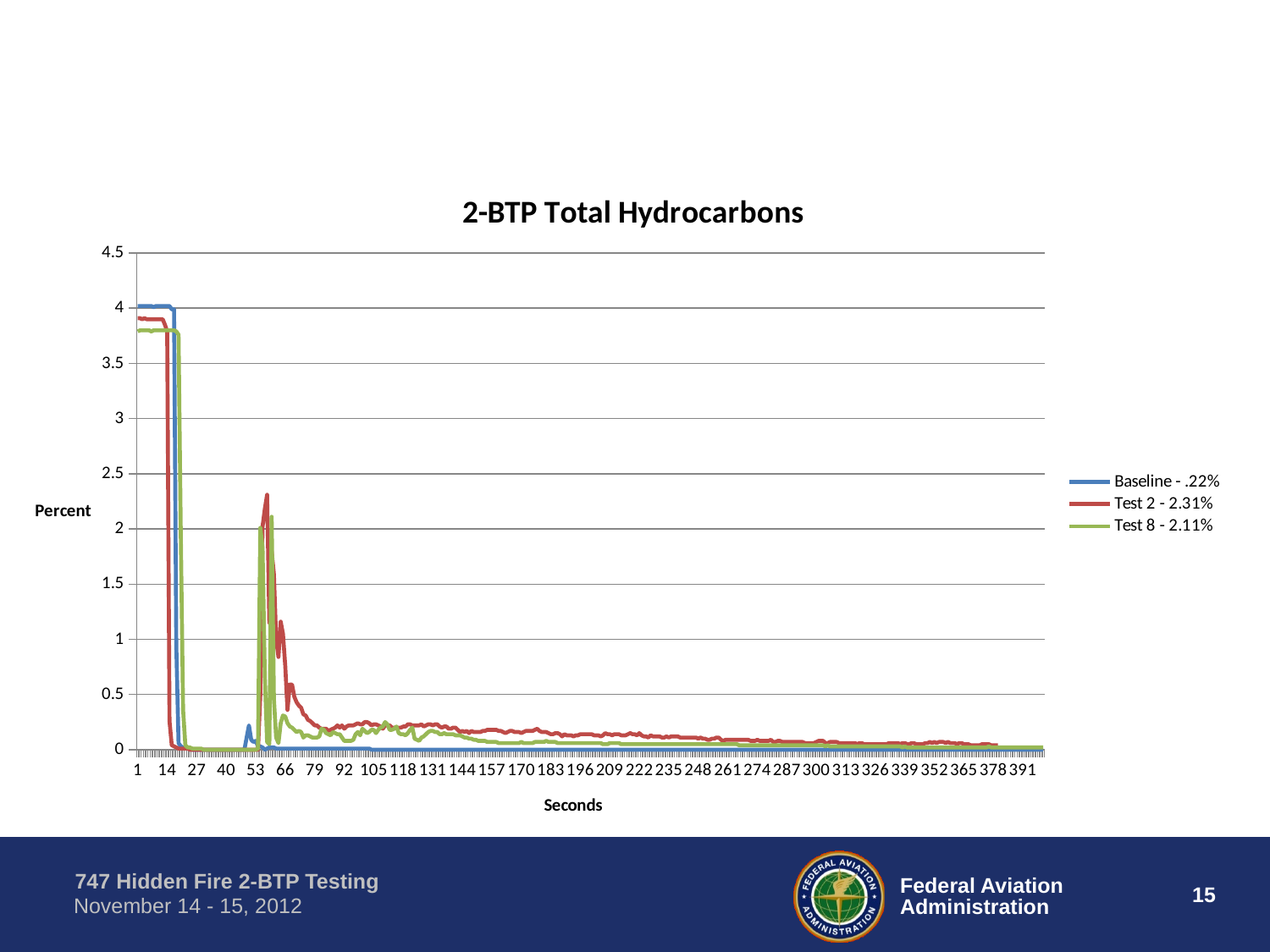
At around 200 seconds, is the Baseline value greater or less than 0.5? less What percentage is shown in the legend entry for Test 2? 2.31% At around 300 seconds, is the Test 2 value greater or less than 0.5? less At the start of the test, which series has the higher value, Baseline or Test 8? Baseline Overall, do the plotted values rise or fall from the left of the x axis to the right? fall At its second peak around 60 seconds, is the Test 2 value greater or less than 2? greater What kind of chart is shown on the slide? line chart What is the title of the chart? 2-BTP Total Hydrocarbons How many series does the legend list? 3 After its peak around 60 seconds, does the Test 2 line rise or fall as seconds increase? fall